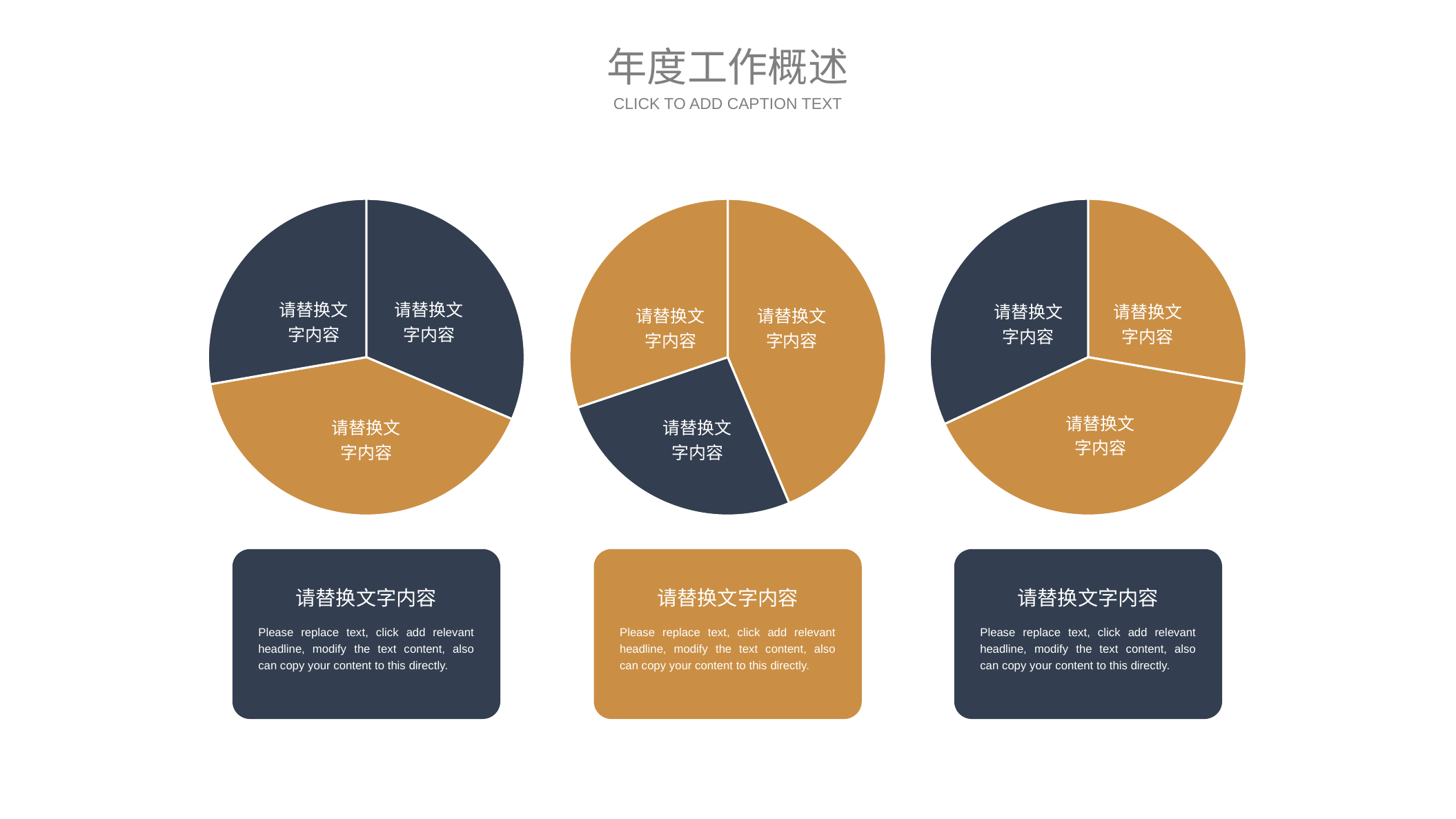
What kind of chart is the left chart on the slide? pie chart How many slices does the left pie chart have? 3 What kind of chart is the right chart on the slide? pie chart How many slices does the right pie chart have? 3 In the left pie chart, how many slices are coloured dark blue? 2 How many pie charts are shown on the slide? 3 In the middle pie chart, which is larger: the dark blue slice or the gold slice on the right? the gold slice on the right In the middle pie chart, how many slices are coloured gold? 2 What kind of chart is the middle chart on the slide? pie chart